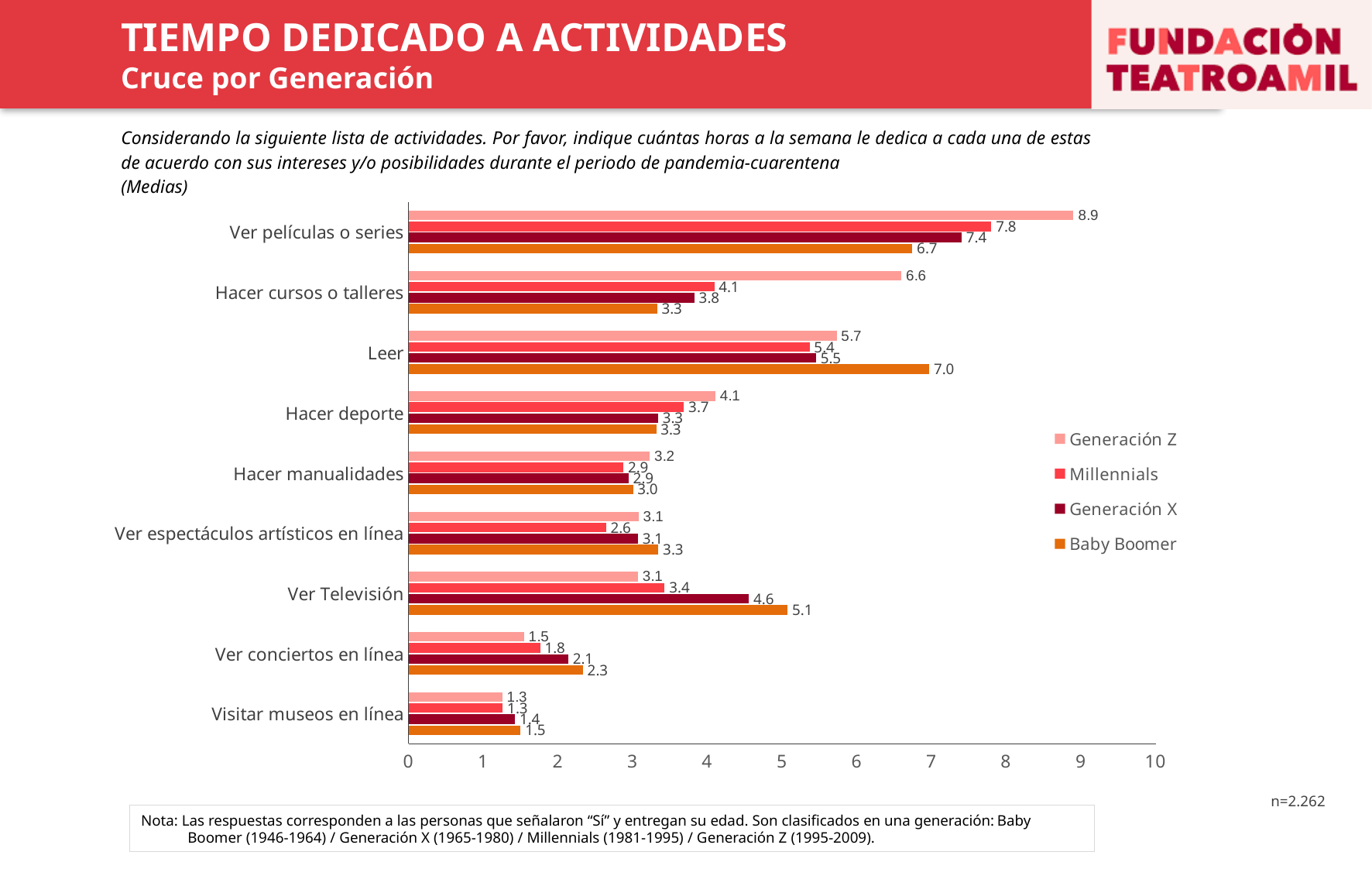
What is the value for Generación Z for Ver películas o series? 8.9 What kind of chart is shown on the slide? Bar chart What is the value for Baby Boomer for Leer? 7.0 What is the value for Generación X for Ver Televisión? 4.6 How many activities are shown on the chart? 9 Which activity has the lowest value for Baby Boomer? Visitar museos en línea How many series does the legend list? 4 Which series is shown in orange in the legend? Baby Boomer What is the value for Millennials for Hacer cursos o talleres? 4.1 What is the difference between the Generación Z and Baby Boomer values for Hacer cursos o talleres? 3.3 For Ver Televisión, which is larger: the Generación Z value or the Baby Boomer value? Baby Boomer Which activity has the highest value for Generación Z? Ver películas o series